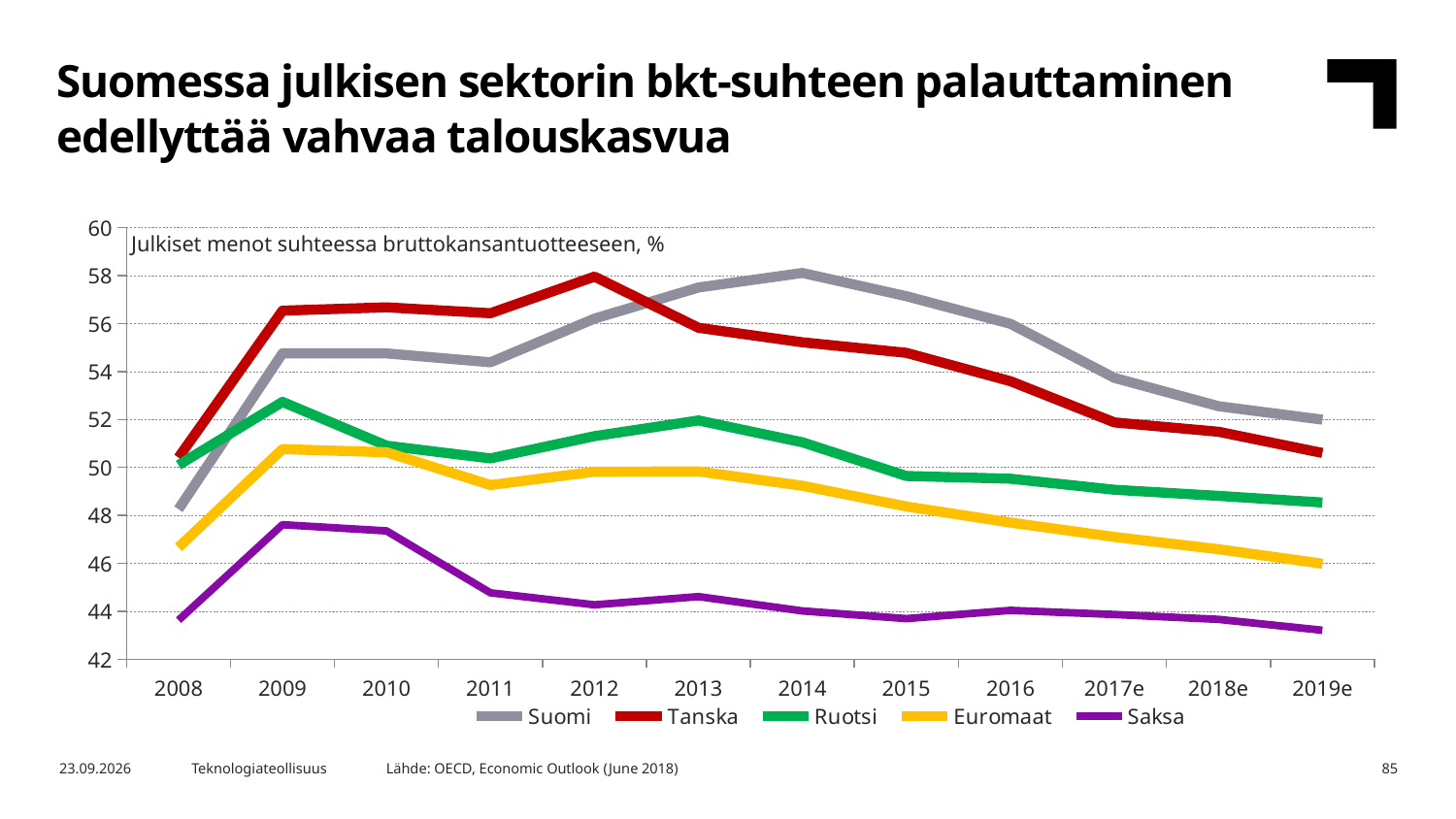
Is the value for Saksa in 2019e greater or less than 44? less In 2012, which is higher: Tanska or Suomi? Tanska Which series has the lowest value in 2019e? Saksa What kind of chart is shown on the slide? line chart How many series does the legend list? 5 Is the value for Suomi in 2014 greater or less than 56? greater Is the value for Euromaat in 2009 greater or less than 50? greater How many years are shown on the x axis? 12 Which series has the highest value in 2014? Suomi Does the Suomi line rise or fall from 2014 to 2019e? fall In 2016, which is higher: Suomi or Tanska? Suomi What is the text label shown inside the chart area at the top? Julkiset menot suhteessa bruttokansantuotteeseen, %